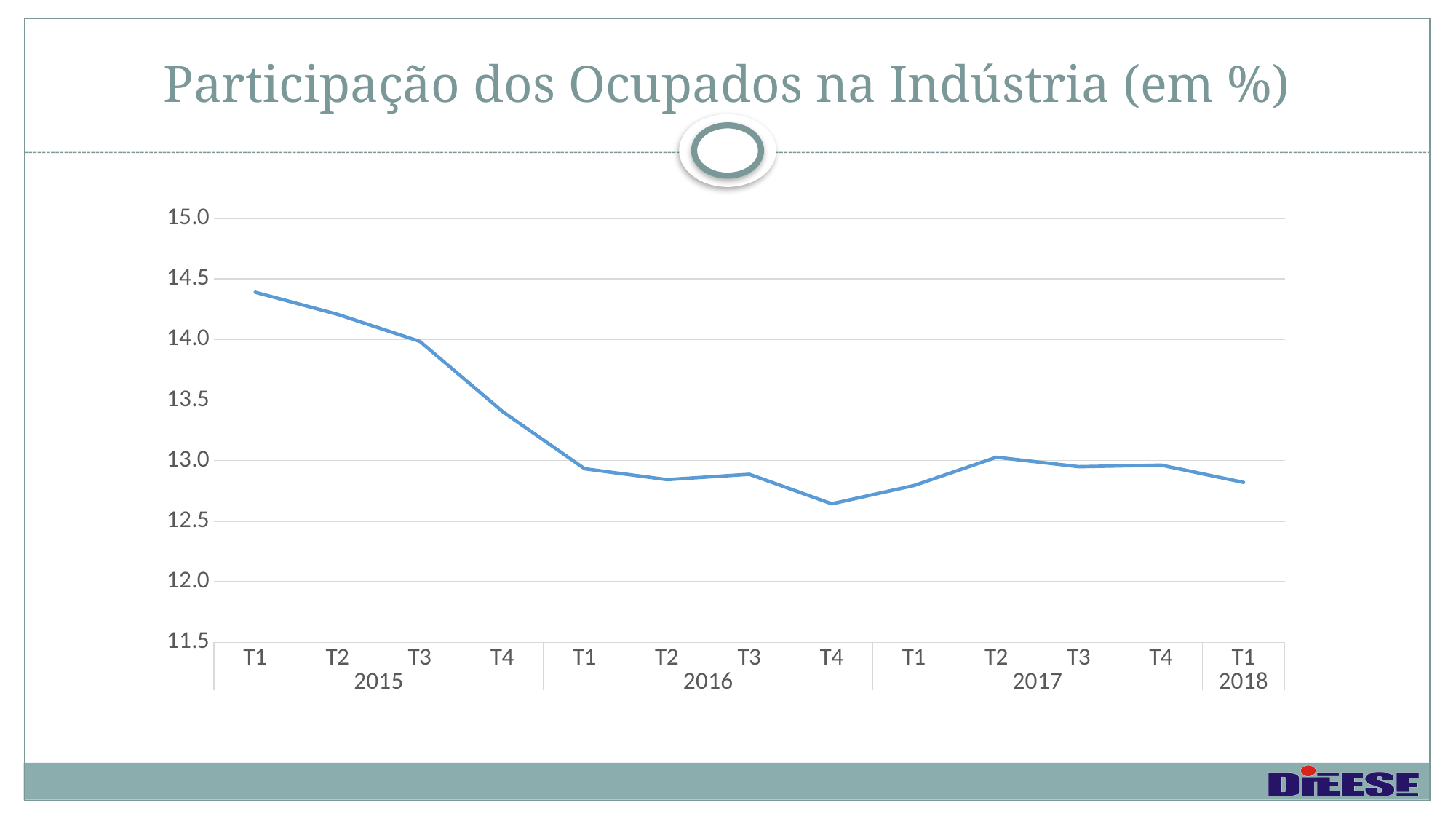
What is the title of the chart? Participação dos Ocupados na Indústria (em %) Which quarter has the lowest value on the chart? T4 2016 Is the value for T4 2015 greater or less than 13.0? greater Which is larger, the value for T4 2016 or the value for T2 2017? T2 2017 How many quarterly data points are plotted on the chart? 13 What kind of chart is shown on the slide? line chart Is the value for T1 2015 greater or less than 14.0? greater Overall, does the value rise or fall from T1 2015 to T1 2018? fall Which is larger, the value for T1 2015 or the value for T1 2018? T1 2015 Is the value for T4 2016 greater or less than 13.0? less Which quarter has the highest value on the chart? T1 2015